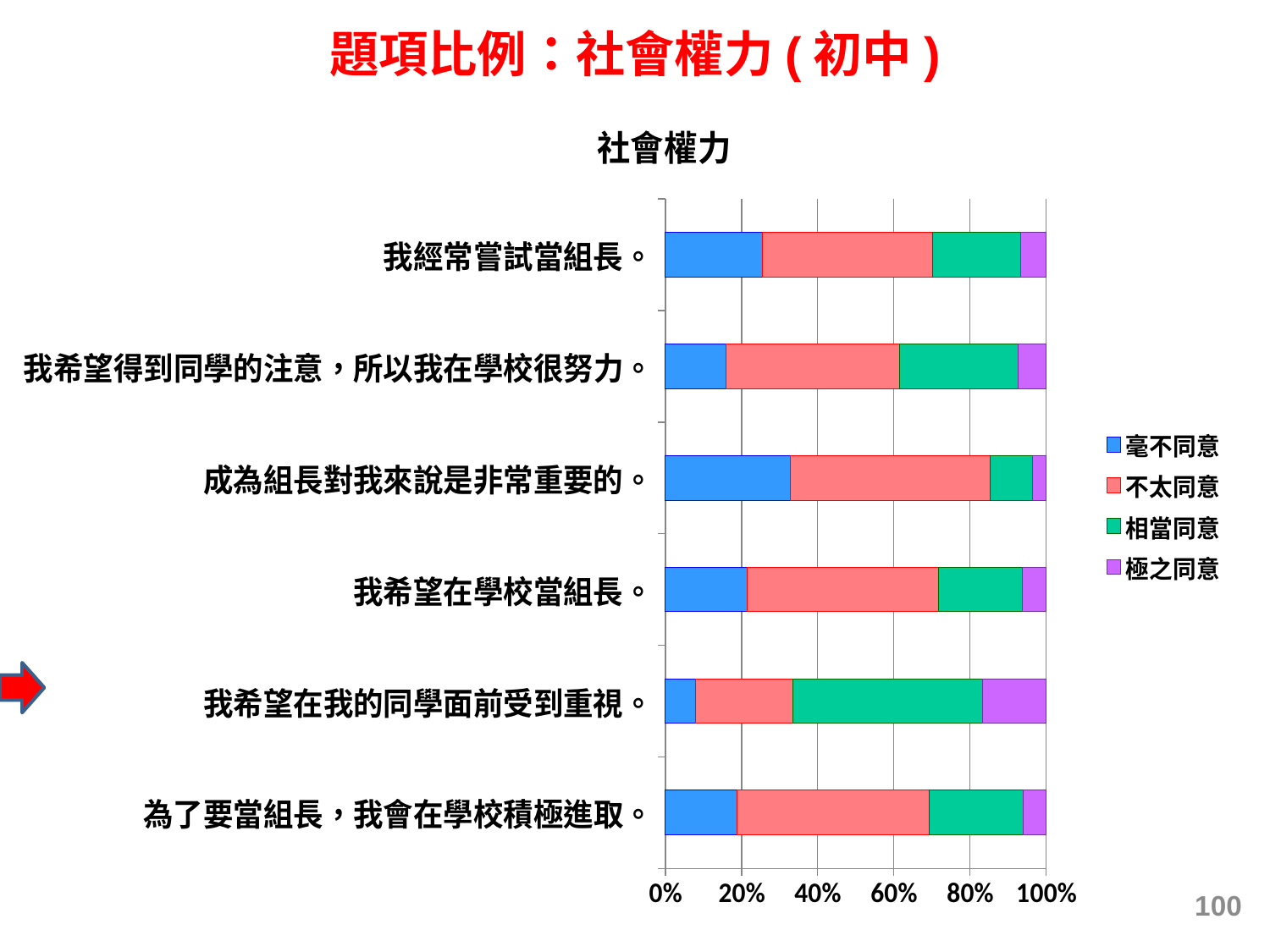
Which series is shown in blue according to the legend? 毫不同意 Is the 毫不同意 share for 我希望在我的同學面前受到重視。 greater or less than 20%? less Which has the larger 毫不同意 share: 我經常嘗試當組長。 or 我希望得到同學的注意，所以我在學校很努力。? 我經常嘗試當組長。 Is the 毫不同意 share for 成為組長對我來說是非常重要的。 greater or less than 20%? greater What kind of chart is shown on the slide? stacked bar chart Which statement has the smallest 毫不同意 segment? 我希望在我的同學面前受到重視。 How many statements (categories) are plotted on the chart? 6 How many series does the legend list? 4 Which statement has the largest 極之同意 segment? 我希望在我的同學面前受到重視。 Which statement has the largest 相當同意 segment? 我希望在我的同學面前受到重視。 Which statement has the largest 毫不同意 segment? 成為組長對我來說是非常重要的。 What is the title of the chart? 社會權力